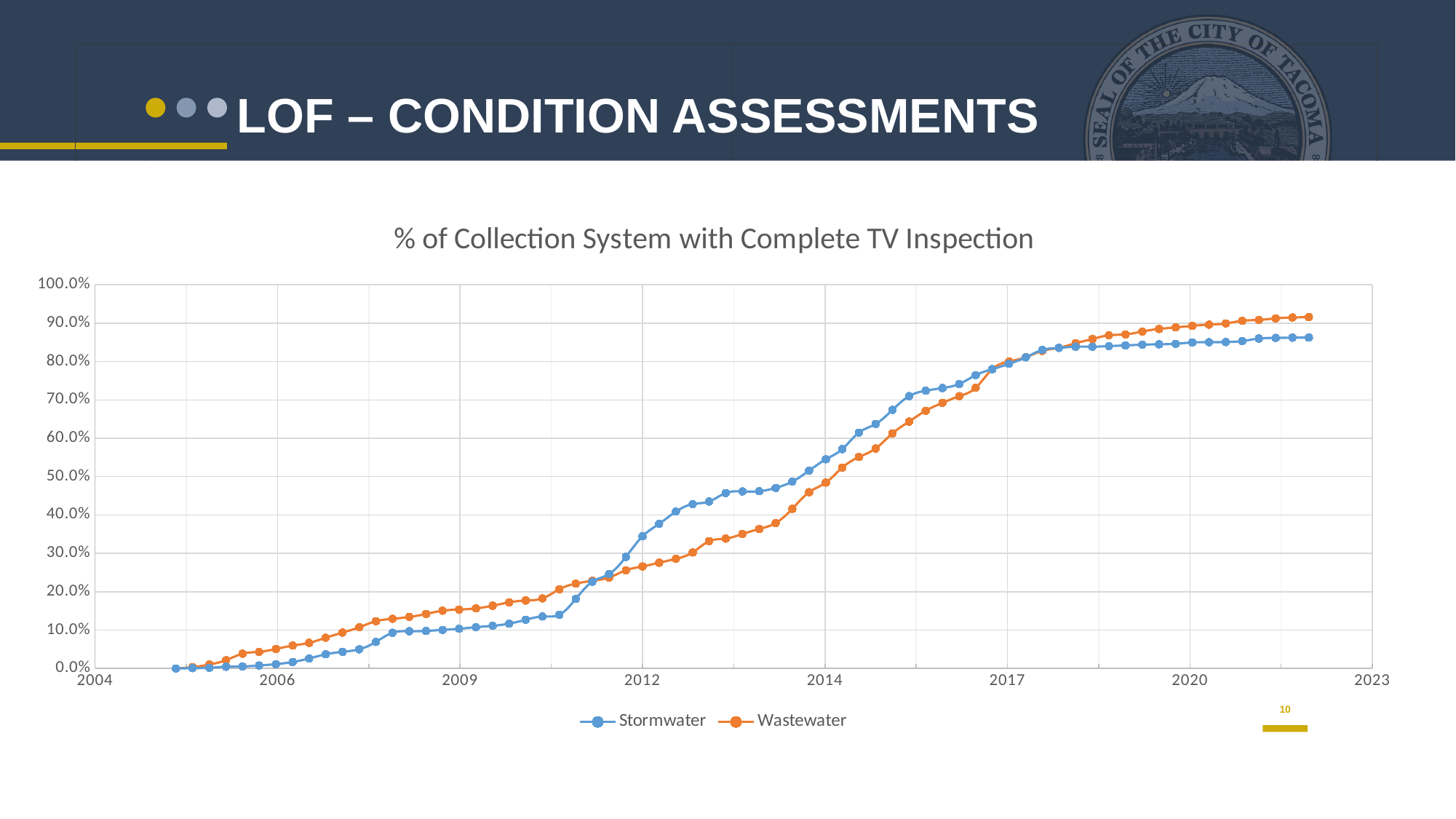
Is the Wastewater value at 2020 greater or less than 80.0%? greater Which series is drawn in orange? Wastewater What is the title of the chart? % of Collection System with Complete TV Inspection At 2020, which series has the higher value, Stormwater or Wastewater? Wastewater At 2012, which series has the higher value, Stormwater or Wastewater? Stormwater What kind of chart is shown on the slide? line chart Do the Stormwater values rise or fall over time along the x axis? rise Is the Stormwater value at 2006 greater or less than 10.0%? less How many series does the legend list? 2 Is the Wastewater value at 2012 greater or less than 30.0%? less